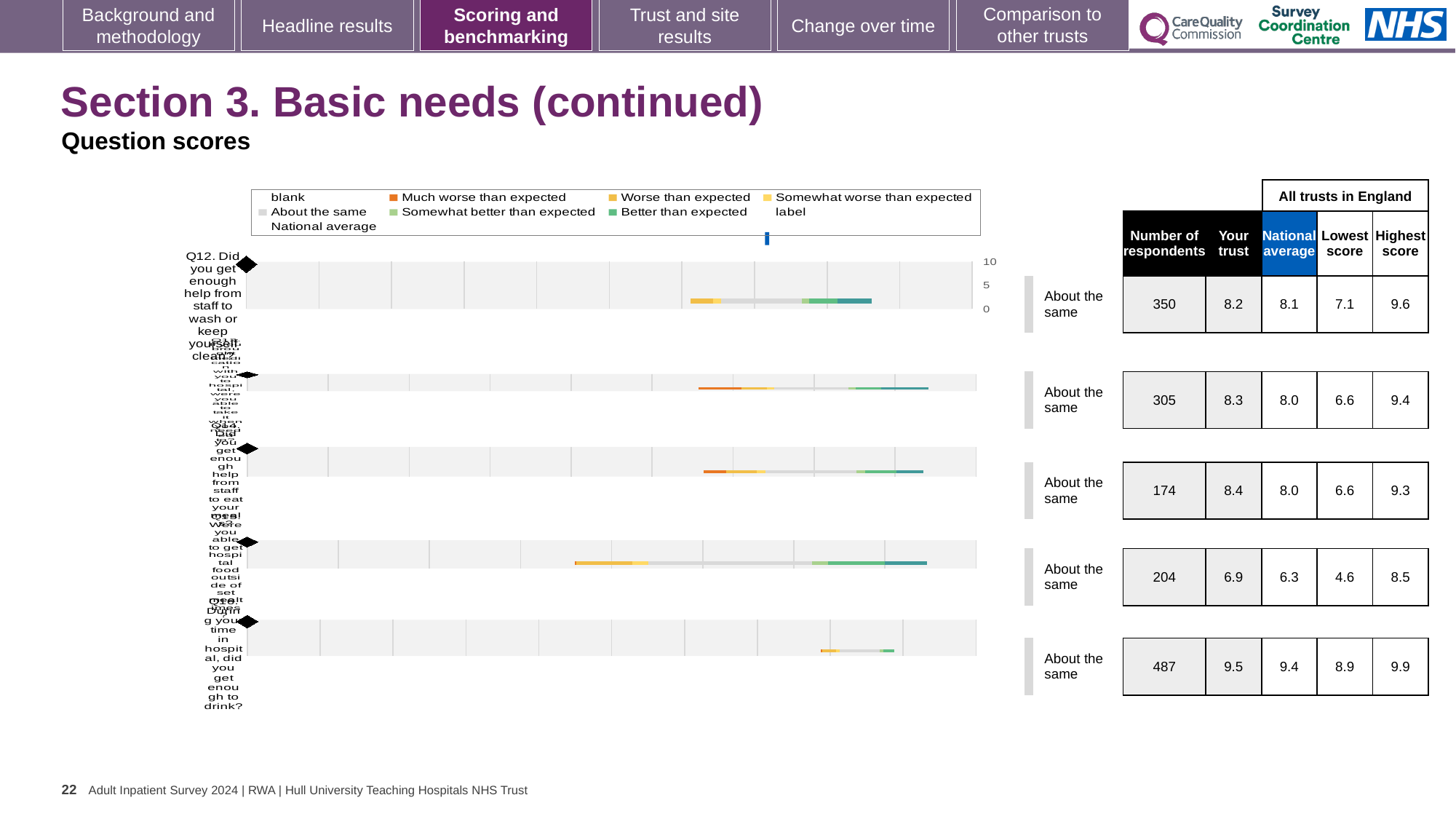
How many question rows (bars) are plotted in the chart? 5 Which row has the lowest 'Your trust' score in the table beside the chart? the fourth row, 6.9 For the fourth row of the chart, is the 'Your trust' score (6.9) larger or smaller than the national average (6.3)? larger What benchmark category is shown for every row of the chart? About the same Which row has the highest 'Your trust' score in the table beside the chart? the fifth (bottom) row, 9.5 What kind of chart is shown on the slide? bar chart What is the national average shown for Q12 (help from staff to wash or keep yourself clean)? 8.1 What is the 'Your trust' score shown for Q12 (Did you get enough help from staff to wash or keep yourself clean?)? 8.2 How many respondents are shown for Q12 (help from staff to wash or keep yourself clean)? 350 What is the highest score across all trusts in England shown for the bottom row of the chart? 9.9 What is the difference between the 'Your trust' score and the national average for Q12? 0.1 What is the lowest score across all trusts in England shown for the fourth row of the chart? 4.6